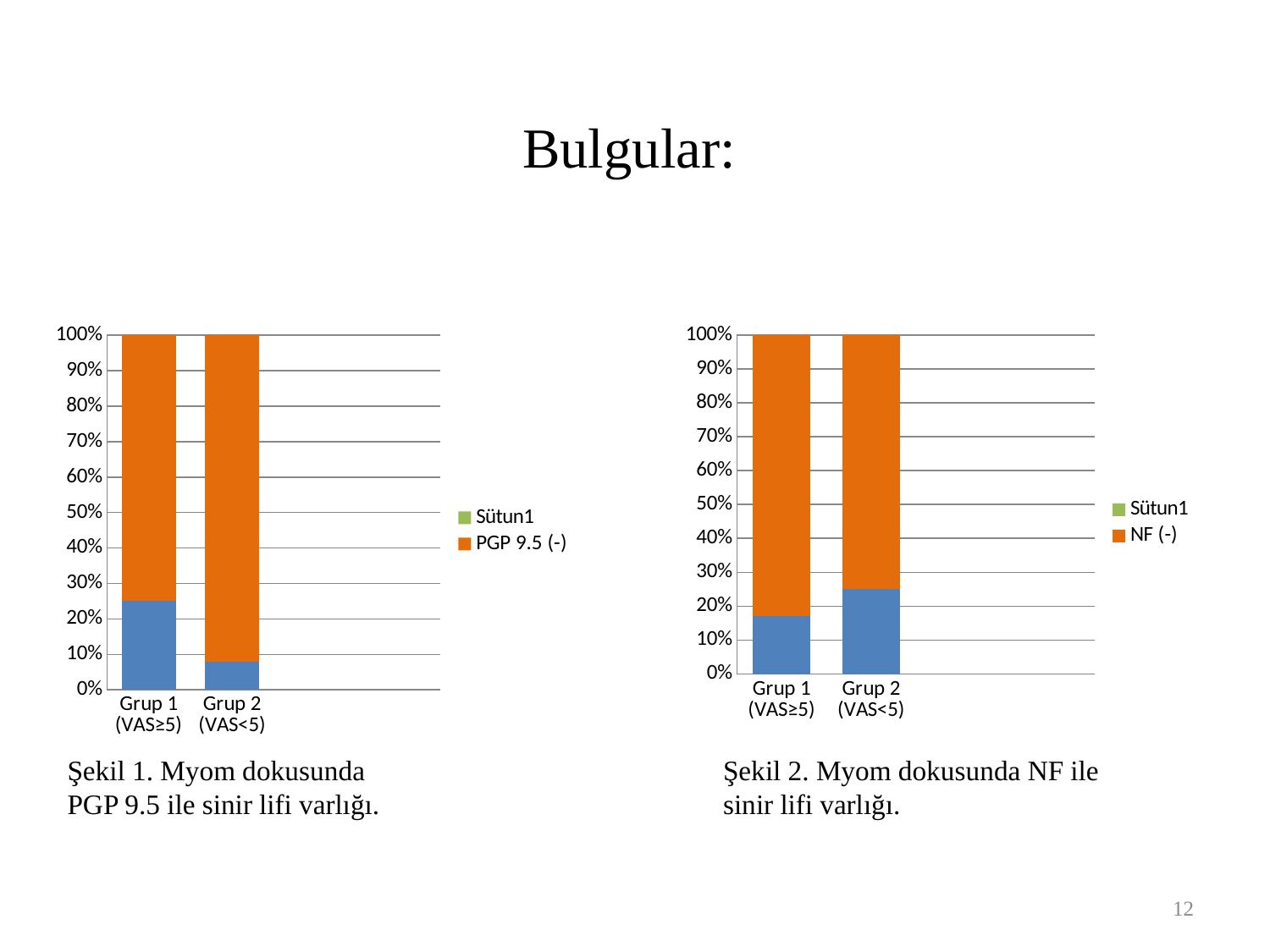
How many entries does the legend of the left chart (Şekil 1) list? 2 How many categories are shown on the x axis of the right chart (Şekil 2)? 2 In the right chart (Şekil 2), is the blue segment for Grup 1 (VAS≥5) greater or less than 20%? less In the left chart (Şekil 1), which group has the larger blue segment, Grup 1 (VAS≥5) or Grup 2 (VAS<5)? Grup 1 (VAS≥5) What is the caption of the left chart? Şekil 1. Myom dokusunda PGP 9.5 ile sinir lifi varlığı. In the left chart (Şekil 1), is the blue segment for Grup 1 (VAS≥5) greater or less than 20%? greater In the right chart (Şekil 2), is the blue segment for Grup 2 (VAS<5) greater or less than 20%? greater What is the total height of each stacked bar in the right chart (Şekil 2)? 100% What kind of chart is the left chart (Şekil 1)? stacked bar chart What is the name of the orange series in the legend of the right chart (Şekil 2)? NF (-) In the right chart (Şekil 2), which group has the larger orange NF (-) segment, Grup 1 (VAS≥5) or Grup 2 (VAS<5)? Grup 1 (VAS≥5)